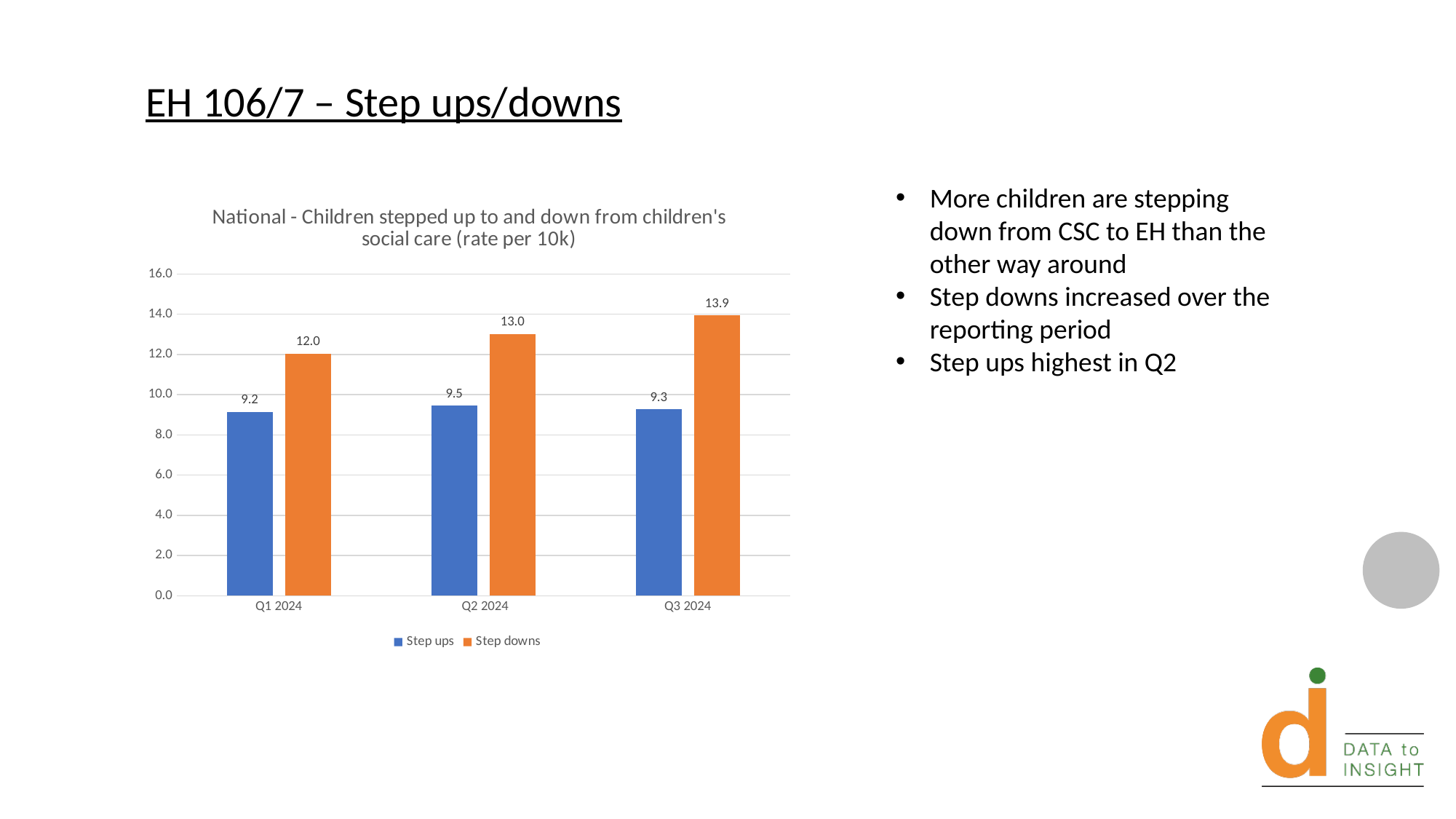
What kind of chart is shown on the slide? Bar chart What is the Step downs value for Q2 2024? 13.0 How many series does the legend list? 2 Which is larger in Q1 2024, Step ups or Step downs? Step downs In which quarter is the Step downs value lowest? Q1 2024 What is the Step ups value for Q1 2024? 9.2 What is the Step downs value for Q3 2024? 13.9 Is the Step downs value for Q2 2024 greater or less than 12.0? greater In which quarter is the Step ups value highest? Q2 2024 Do the Step downs values rise or fall from Q1 2024 to Q3 2024? Rise What is the difference between Step downs and Step ups in Q3 2024? 4.6 How many quarters are shown on the x axis? 3